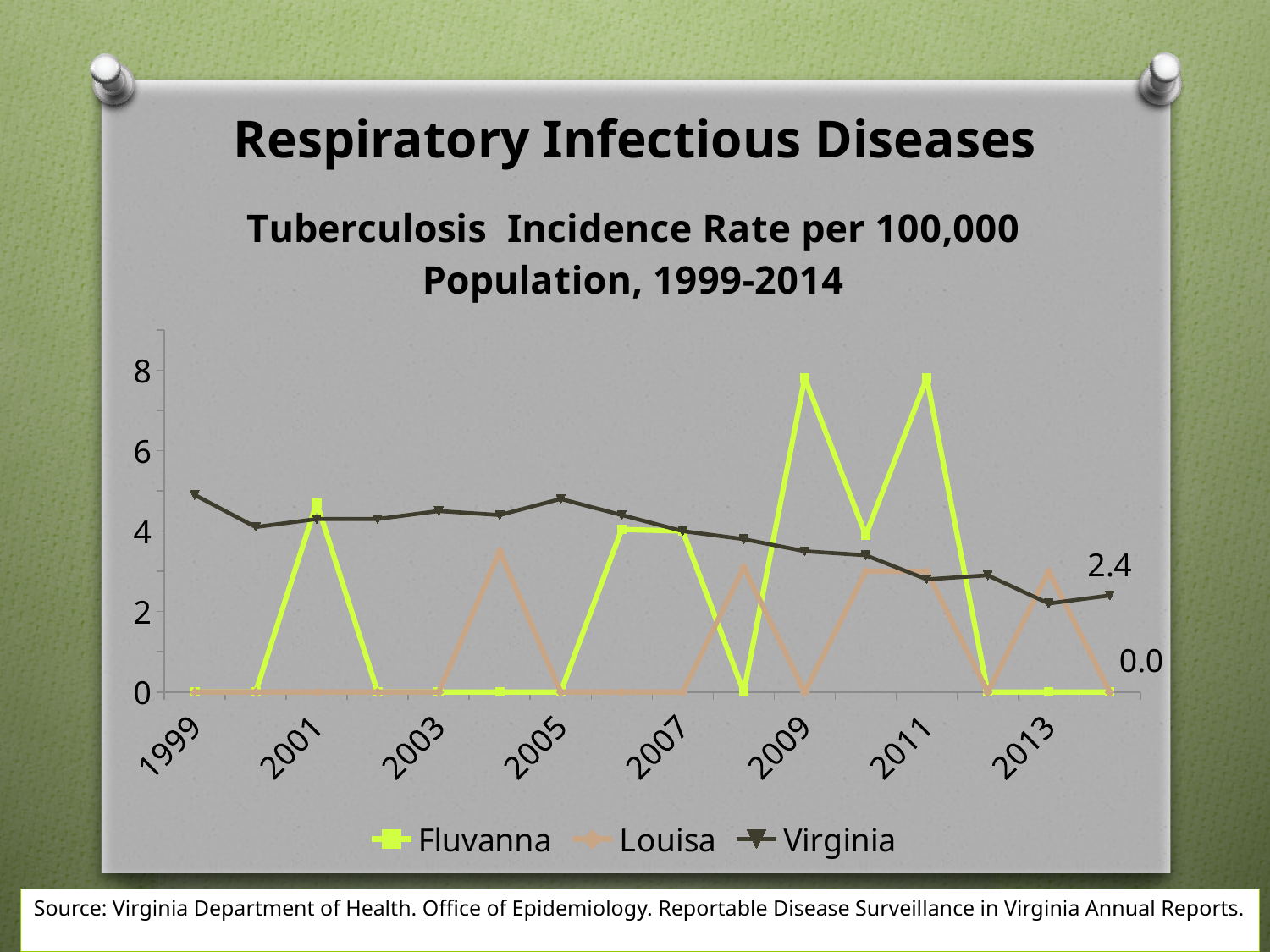
In 2004, which is larger: the value for Virginia or the value for Louisa? Virginia Is the value for Fluvanna in 2009 greater or less than 6? greater Which series are listed in the legend? Fluvanna, Louisa, Virginia Which series has the highest value in 2009? Fluvanna What is the title of the chart? Tuberculosis Incidence Rate per 100,000 Population, 1999-2014 What type of chart is shown on the slide? line chart Is the value for Virginia in 1999 greater or less than 4? greater How many series does the legend list? 3 How many years are plotted along the x axis? 16 Is the value for Virginia in 2013 greater or less than 4? less What is the value for Virginia in 2014? 2.4 Does the Virginia line generally rise or fall from 1999 to 2014? fall